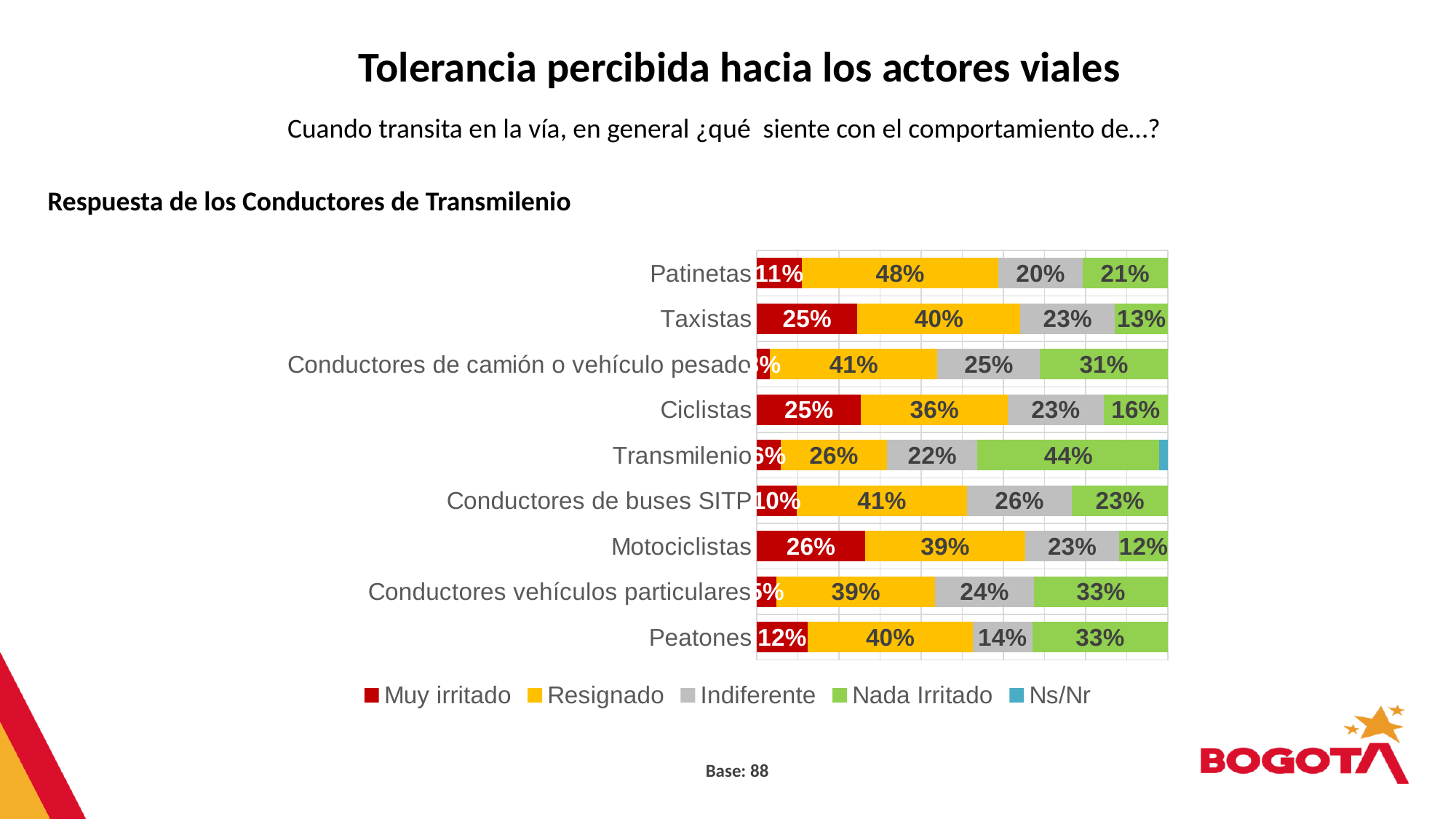
Which category has the highest Nada Irritado value? Transmilenio What is the Indiferente value for Conductores de camión o vehículo pesado? 25% What is the Resignado value for Patinetas? 48% How many series does the legend list? 5 What is the difference between the Resignado value for Taxistas and the Resignado value for Ciclistas? 4 percentage points What colour represents the Muy irritado series in the chart? red Which category has the lowest Indiferente value? Peatones What is the Muy irritado value for Motociclistas? 26% Which has a larger Indiferente value, Conductores de buses SITP or Peatones? Conductores de buses SITP What kind of chart is shown on the slide? bar chart How many road-actor categories are plotted in the chart? 9 What is the Nada Irritado value for Transmilenio? 44%